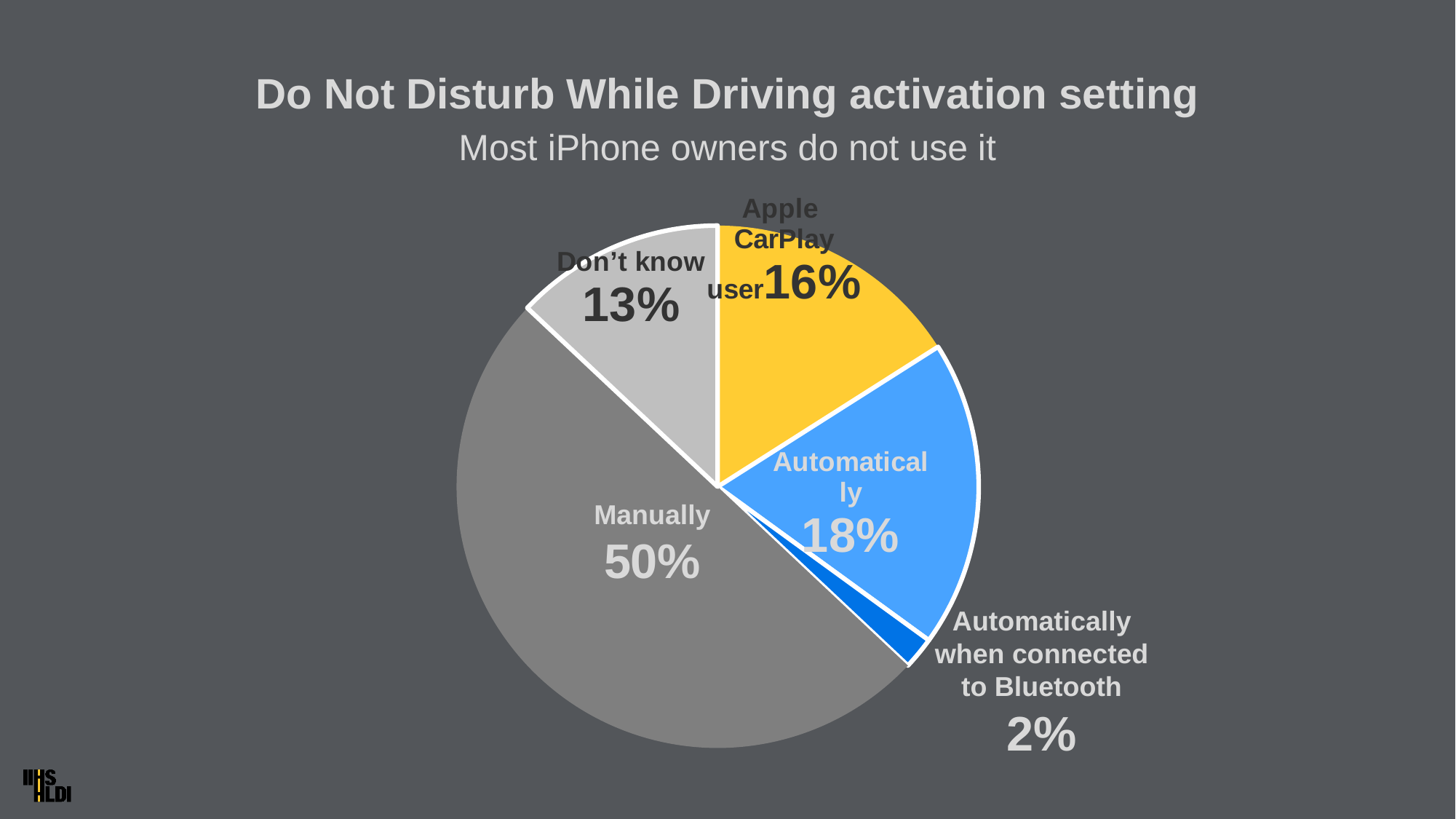
How many slices does the pie chart have? 5 What is the value for "Apple CarPlay user"? 16% Which slice of the pie is the largest? Manually What is the difference between the "Manually" and "Automatically" values? 32% What is the value for "Automatically when connected to Bluetooth"? 2% What is the value for "Don't know"? 13% What kind of chart is shown on the slide? Pie chart What share of the pie is labelled "Manually"? 50% Which slice of the pie is the smallest? Automatically when connected to Bluetooth Which is larger, "Apple CarPlay user" or "Don't know"? Apple CarPlay user What is the value for "Automatically"? 18% What is the title of the chart? Do Not Disturb While Driving activation setting